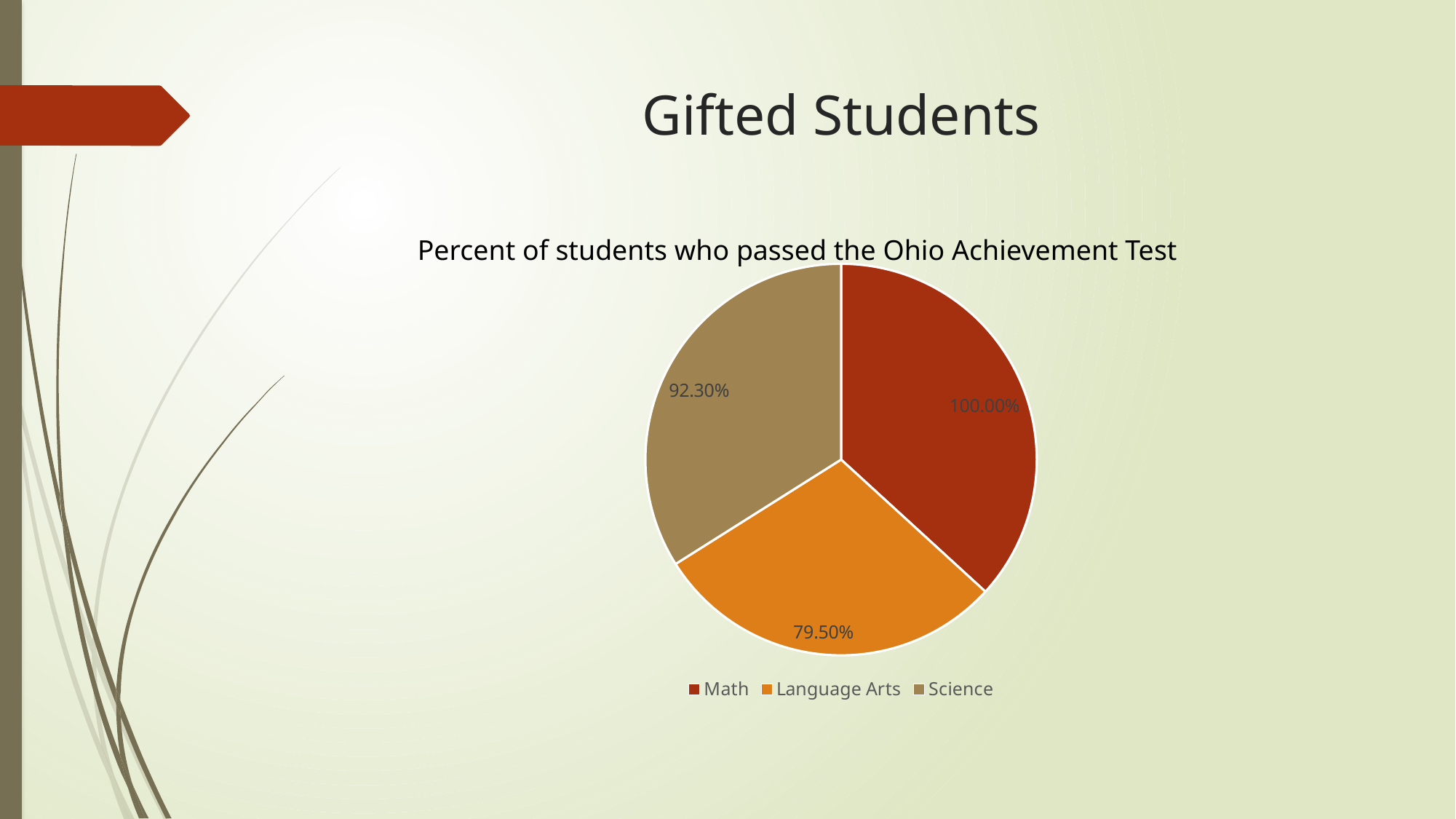
Which subject has the lowest pass rate on the chart? Language Arts Which has a higher pass rate, Science or Language Arts? Science What percent of gifted students passed the Ohio Achievement Test in Language Arts? 79.50% What kind of chart is shown on the slide? Pie chart What is the difference between the Math and Language Arts pass rates? 20.50% Which subject is shown in the orange slice of the pie chart? Language Arts What is the difference between the Science and Language Arts pass rates? 12.80% What percent of gifted students passed the Ohio Achievement Test in Math? 100.00% Which subject has the highest pass rate on the chart? Math What percent of gifted students passed the Ohio Achievement Test in Science? 92.30% How many subjects are shown in the pie chart? 3 What is the title of the chart? Percent of students who passed the Ohio Achievement Test